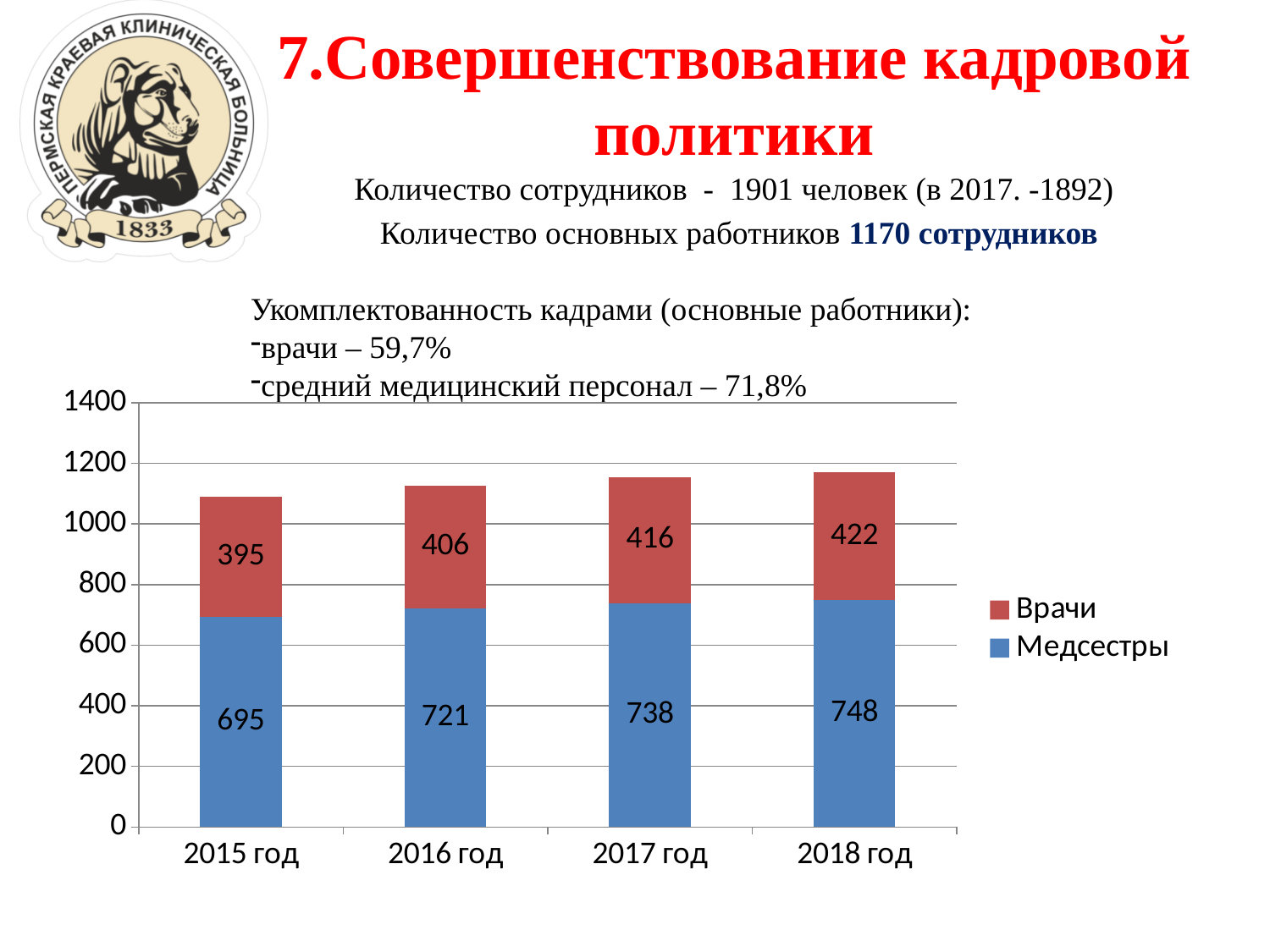
Which is larger: the Врачи value in 2017 год or the Врачи value in 2016 год? 2017 год How many years are shown on the x axis? 4 What is the value for Медсестры in 2016 год? 721 What is the difference between the Медсестры values in 2018 год and 2015 год? 53 What is the value for Врачи in 2015 год? 395 In which year is the value for Врачи the lowest? 2015 год What kind of chart is shown on the slide? Stacked bar chart What is the total of the stacked bar for 2018 год? 1170 What is the value for Врачи in 2018 год? 422 In which year is the value for Медсестры the highest? 2018 год How many series does the legend list? 2 What is the total of the stacked bar for 2015 год? 1090